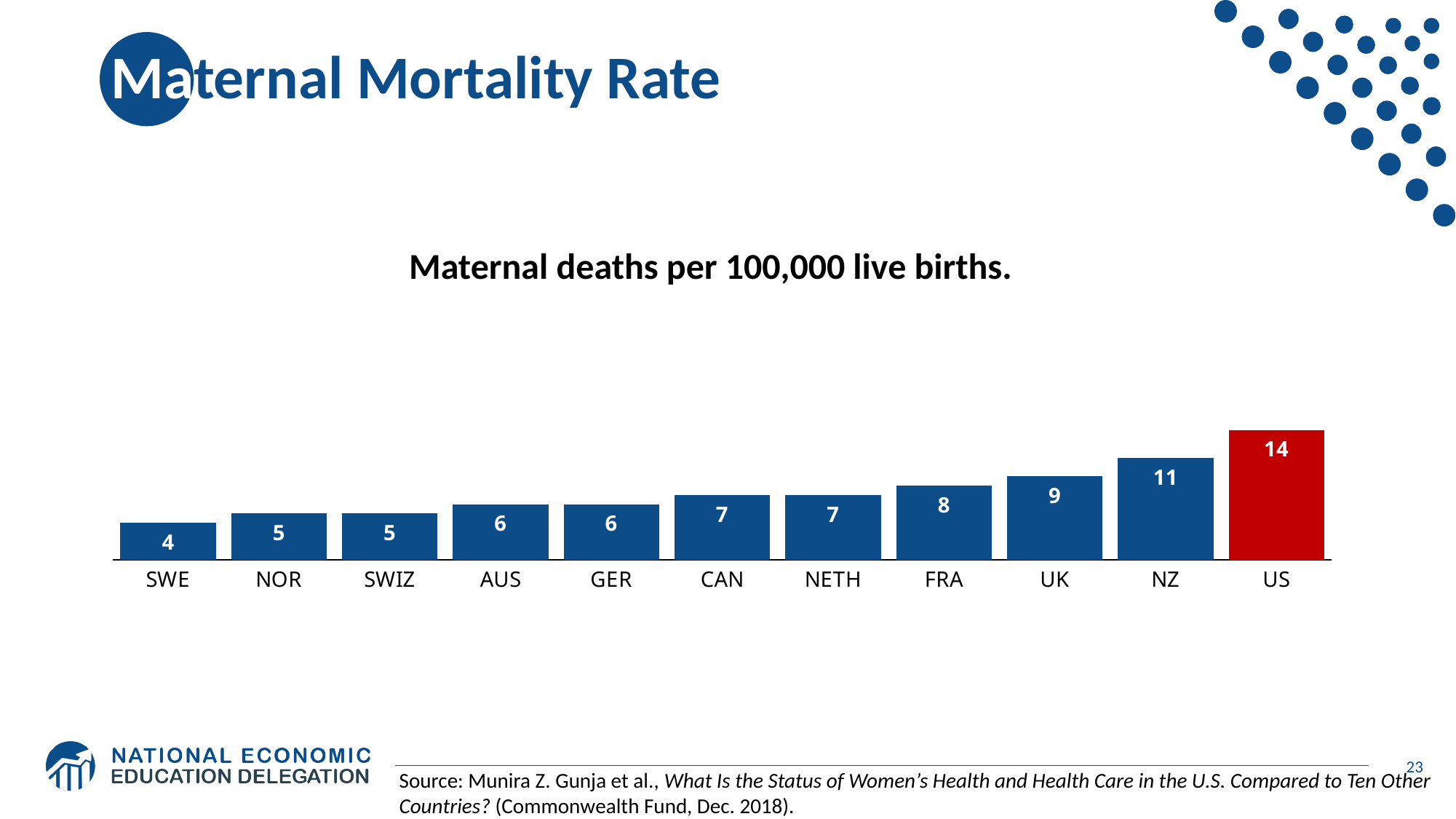
What is the value shown for SWE? 4 What is the value shown for NZ? 11 What is the maternal mortality rate for the US? 14 Which country has the lowest maternal mortality rate? SWE What is the value shown for FRA? 8 Which country has the highest maternal mortality rate? US How many countries are shown in the chart? 11 Which has a higher value, UK or FRA? UK What is the difference between the values for the US and NZ? 3 What kind of chart is shown on the slide? Bar chart What is the difference between the values for the UK and SWE? 5 Which bar is coloured red rather than blue? US